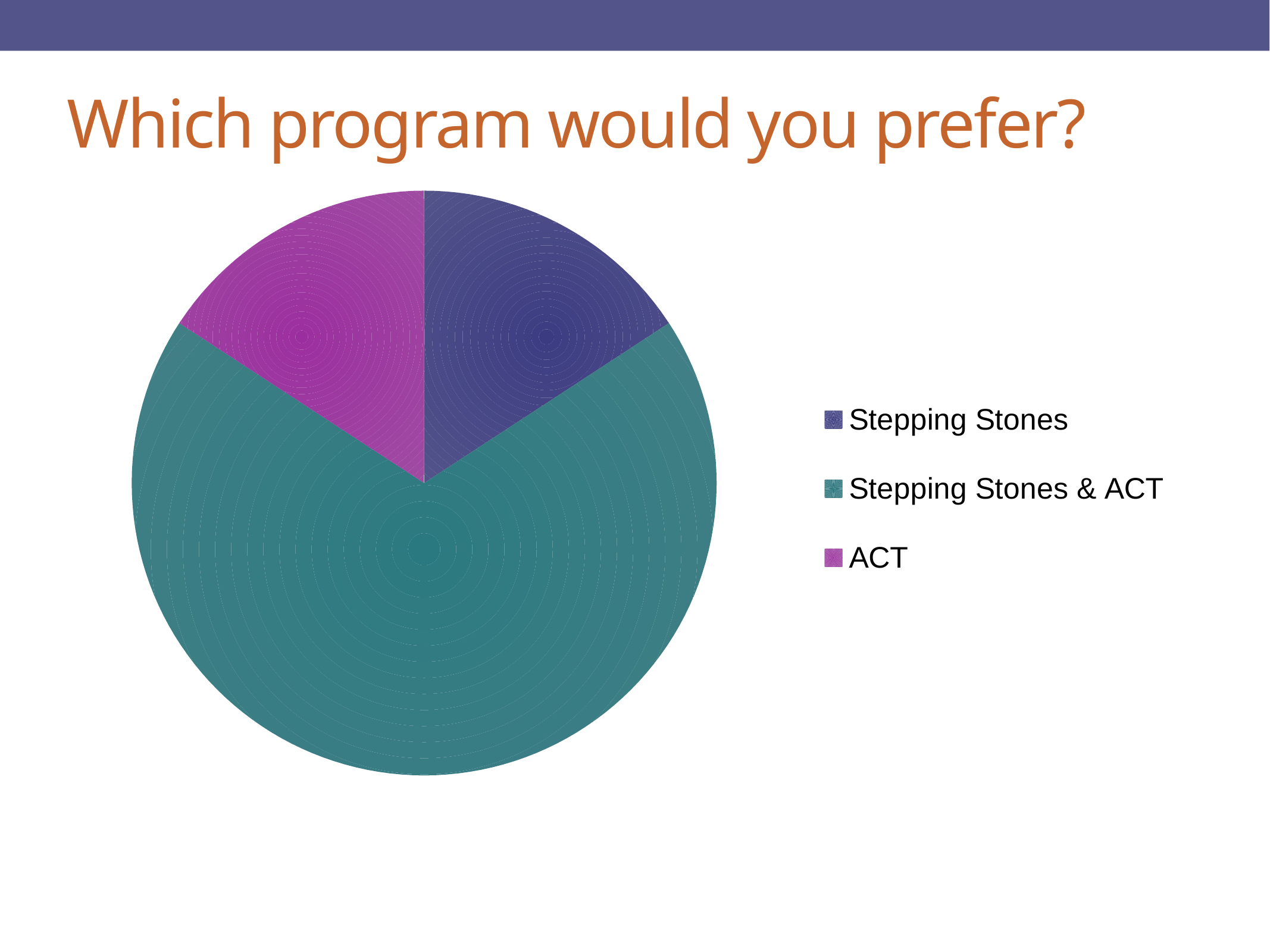
What is the title of the slide containing the pie chart? Which program would you prefer? How many entries does the legend of the pie chart list? 3 Which legend entry is shown in teal in the pie chart? Stepping Stones & ACT Which slice is larger: Stepping Stones or Stepping Stones & ACT? Stepping Stones & ACT Does the Stepping Stones & ACT slice take up more or less than half of the pie? more What kind of chart is shown on the slide? pie chart How many slices does the pie chart have? 3 Which slice is larger: Stepping Stones & ACT or ACT? Stepping Stones & ACT Which program has the largest slice of the pie chart? Stepping Stones & ACT